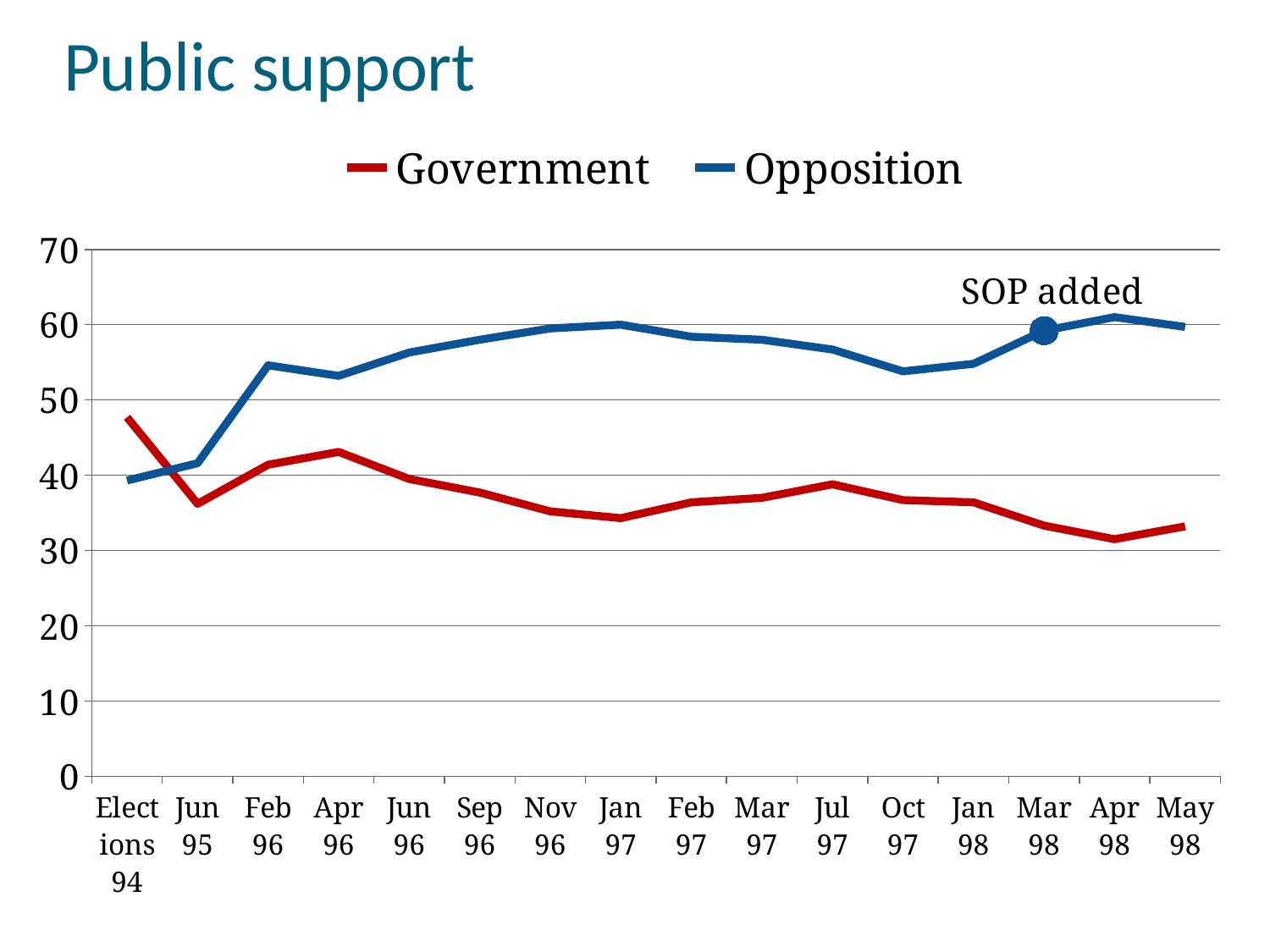
At Elections 94, which series has the higher value, Government or Opposition? Government Is the Opposition value at Feb 96 greater or less than 50? greater At May 98, which series has the higher value, Government or Opposition? Opposition Is the Government value at Elections 94 greater or less than 40? greater How many points are plotted along the x axis for each series? 16 Does the Government series rise or fall from Apr 96 to Jan 97? fall At which point is the Government series highest? Elections 94 Is the Government value at Jan 97 greater or less than 40? less What annotation is attached to the Opposition point at Mar 98? SOP added At which point is the Opposition series lowest? Elections 94 How many series does the legend list? 2 What kind of chart is shown on the slide? line chart